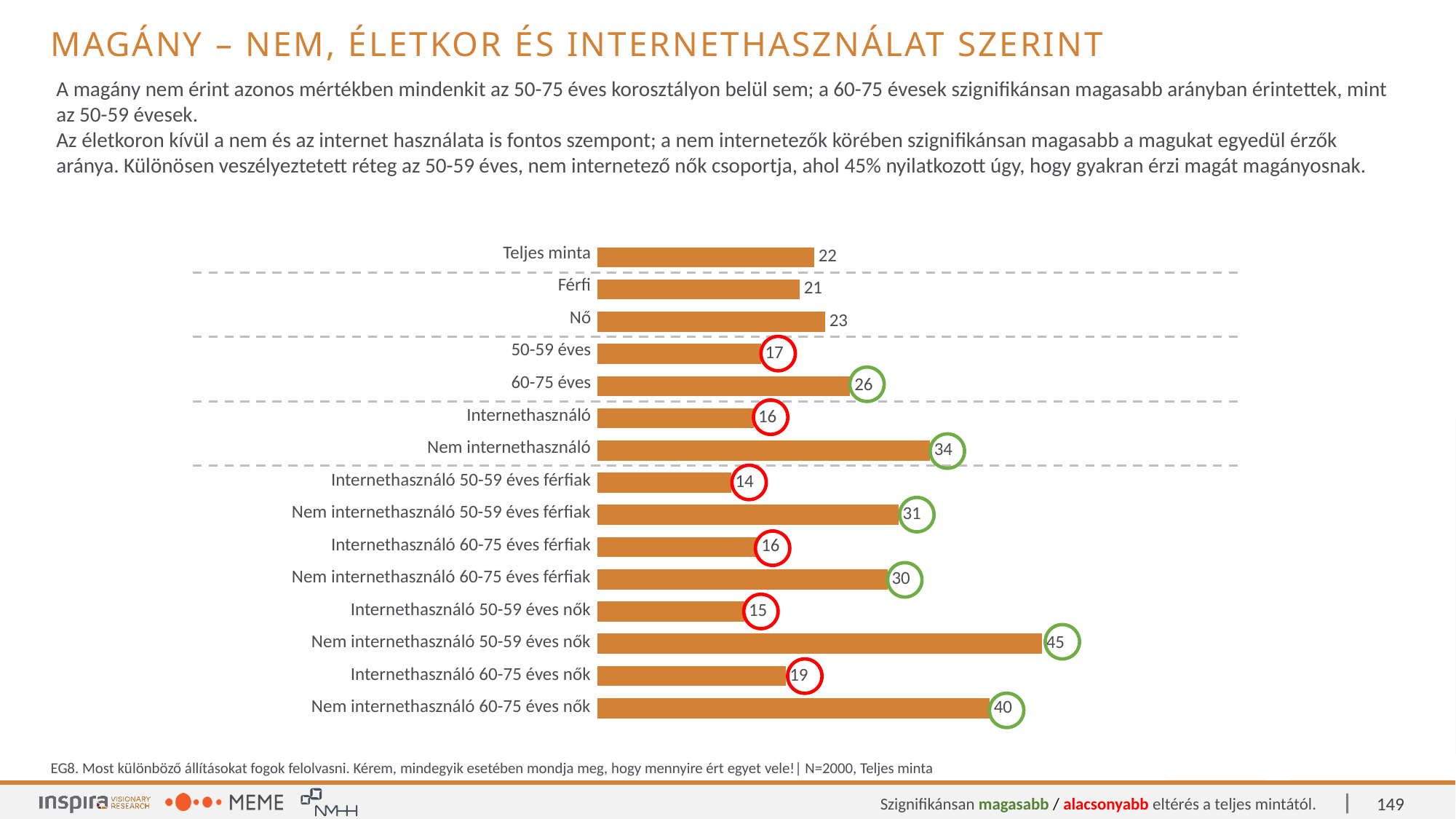
What is the difference between the values for "60-75 éves" and "50-59 éves"? 9 Which has the larger value, "Nő" or "Férfi"? Nő Which category has the highest value? Nem internethasználó 50-59 éves nők Which category has the lowest value? Internethasználó 50-59 éves férfiak What is the value for "60-75 éves"? 26 What is the difference between the values for "Nem internethasználó" and "Internethasználó"? 18 What is the value for "Teljes minta"? 22 What is the value for "Internethasználó 60-75 éves nők"? 19 What kind of chart is shown on the slide? bar chart What is the value for "Nem internethasználó 50-59 éves nők"? 45 Which has the larger value, "Nem internethasználó 60-75 éves nők" or "Nem internethasználó 50-59 éves férfiak"? Nem internethasználó 60-75 éves nők How many categories are shown in the chart? 15